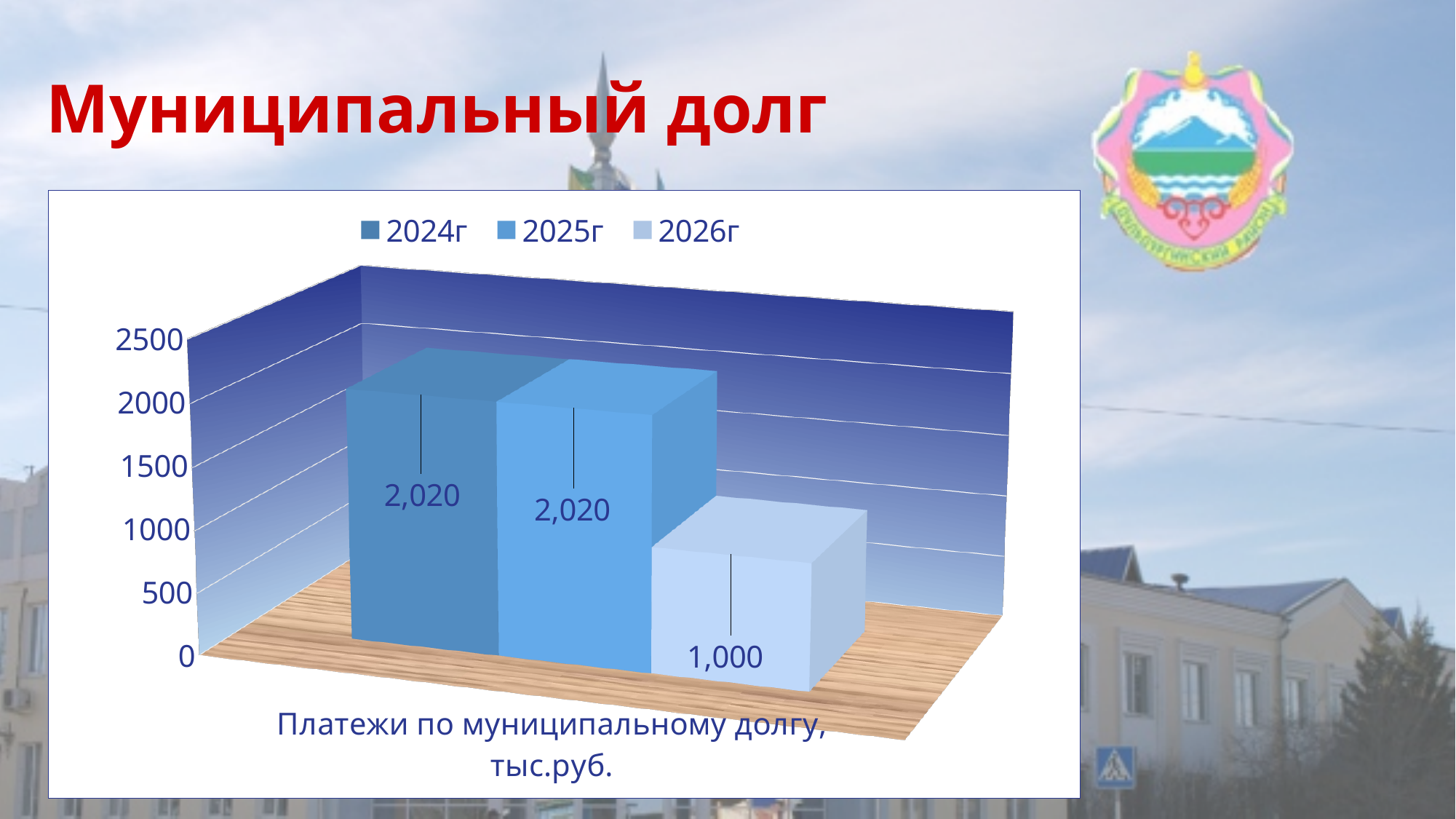
Which is larger, the value for 2024г or the value for 2026г? 2024г What kind of chart is shown on the slide? bar chart What is the value for 2024г in the chart? 2,020 Do the values rise or fall from 2024г to 2026г? fall How many series does the legend list? 3 What is the value for 2025г in the chart? 2,020 Is the value for 2024г greater or less than 1500? greater What is the difference between the values for 2025г and 2026г? 1,020 What is the label shown below the bars in the chart? Платежи по муниципальному долгу, тыс.руб. What is the value for 2026г in the chart? 1,000 Which year has the lowest value in the chart? 2026г Is the value for 2026г greater or less than 1500? less